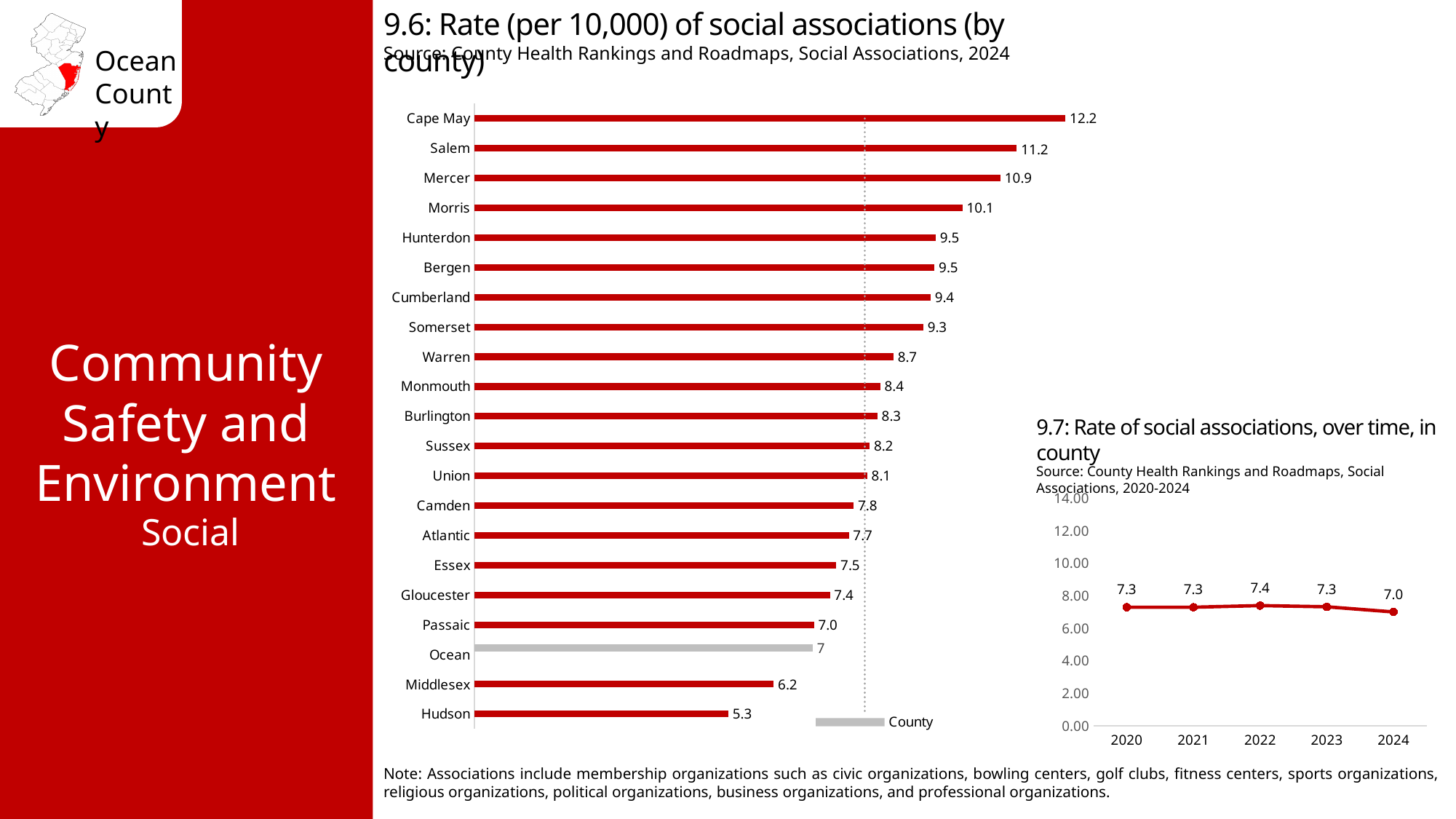
In the chart '9.7: Rate of social associations, over time, in county', how many data points are plotted? 5 In the chart '9.7: Rate of social associations, over time, in county', what is the value for 2022? 7.4 In the chart '9.6: Rate (per 10,000) of social associations (by county)', what is the difference between Salem and Middlesex? 5.0 What type of chart is '9.7: Rate of social associations, over time, in county'? Line chart In the chart '9.6: Rate (per 10,000) of social associations (by county)', which county has the highest rate? Cape May What type of chart is '9.6: Rate (per 10,000) of social associations (by county)'? Bar chart In the chart '9.7: Rate of social associations, over time, in county', which year has the lowest value? 2024 In the chart '9.6: Rate (per 10,000) of social associations (by county)', which is larger, Mercer or Morris? Mercer How many counties are shown in the chart '9.6: Rate (per 10,000) of social associations (by county)'? 21 In the chart '9.6: Rate (per 10,000) of social associations (by county)', what is the value for Cape May? 12.2 In the chart '9.6: Rate (per 10,000) of social associations (by county)', which county has the lowest rate? Hudson In the chart '9.6: Rate (per 10,000) of social associations (by county)', what is the value for Ocean? 7